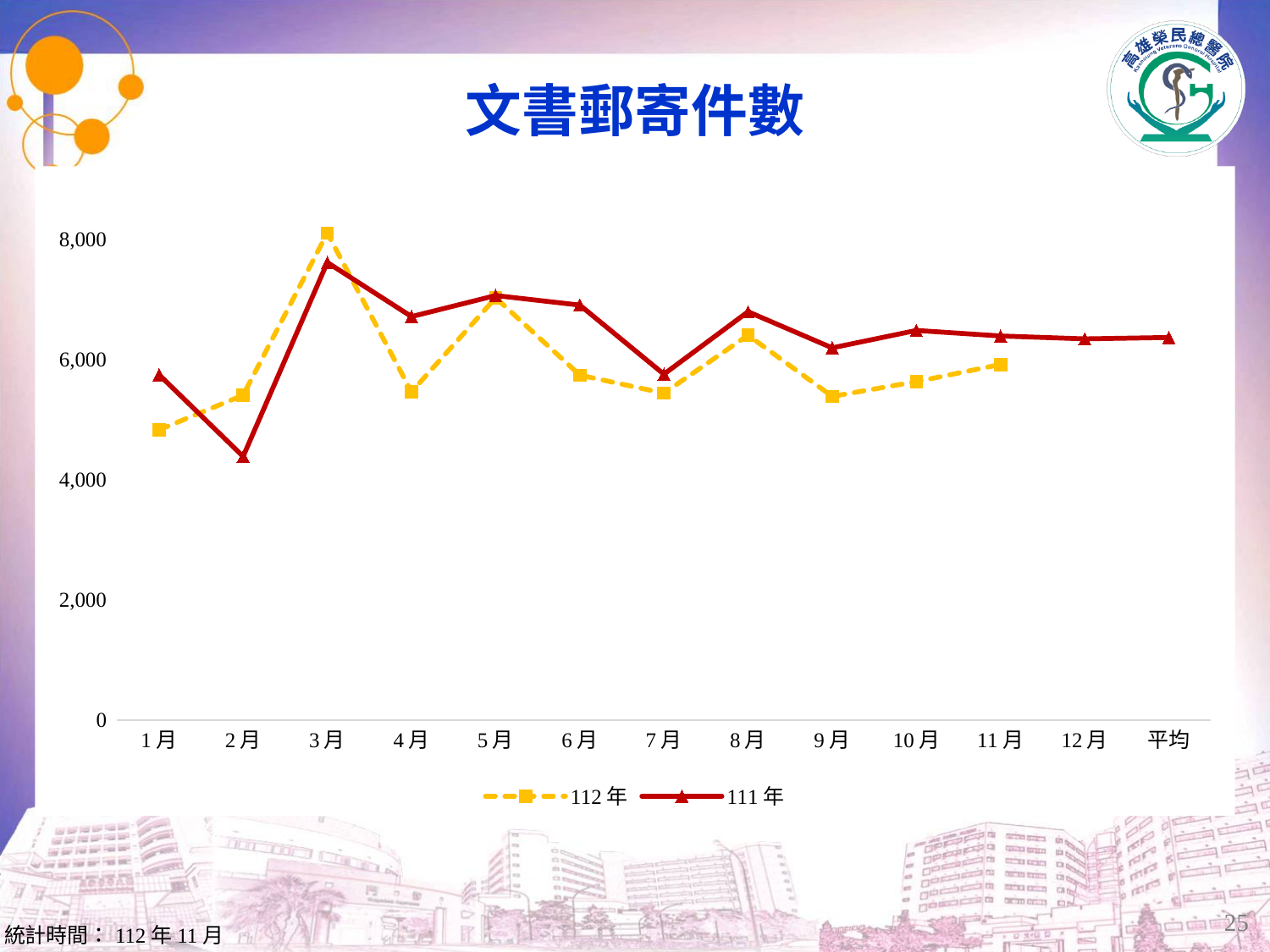
What kind of chart is shown on the slide? line chart In 2月, which series has the higher value, 112年 or 111年? 112年 In which month does the 111年 series reach its lowest value? 2月 Is the 111年 value for 2月 greater or less than 6,000? less How many categories are shown on the x axis? 13 How many series does the legend list? 2 What is the title of the chart? 文書郵寄件數 In which month does the 112年 series reach its highest value? 3月 Is the 112年 value for 1月 greater or less than 6,000? less Is the 111年 value for 5月 greater or less than 6,000? greater In 4月, which series has the higher value, 112年 or 111年? 111年 Does the 112年 series rise or fall from 3月 to 4月? fall